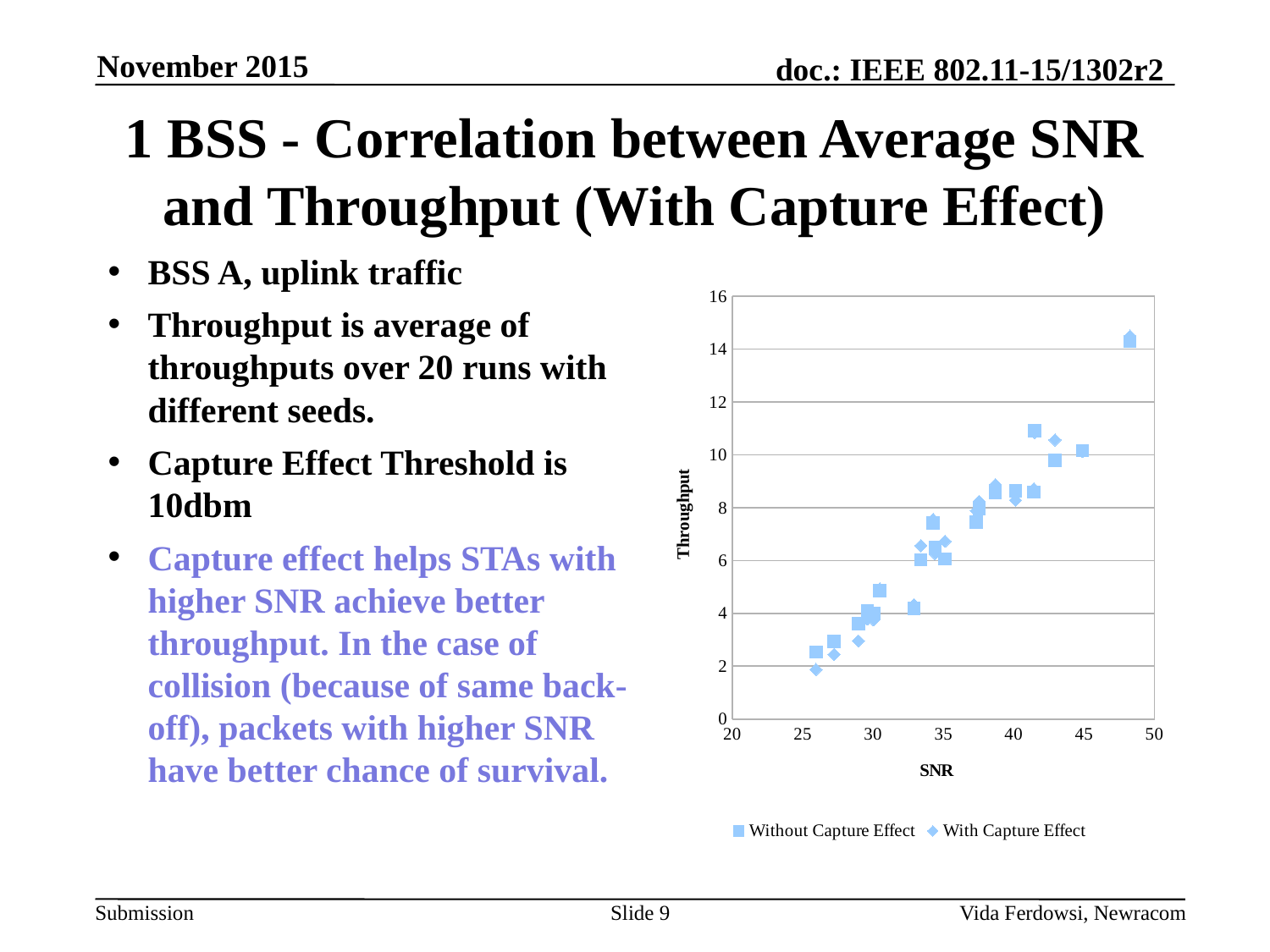
Do the throughput values generally rise or fall as SNR increases along the x axis? rise What is the label of the horizontal axis of the chart? SNR Is the throughput of the point plotted at the highest SNR (around 48) greater or less than 12? greater How many series does the chart legend list? 2 Is the throughput of the points plotted near SNR 30 greater or less than 6? less Is the throughput of the points plotted at the lowest SNR (around 26) greater or less than 4? less What kind of chart is shown on the slide? scatter chart What are the two series named in the chart legend? Without Capture Effect, With Capture Effect What is the maximum value shown on the Throughput axis? 16